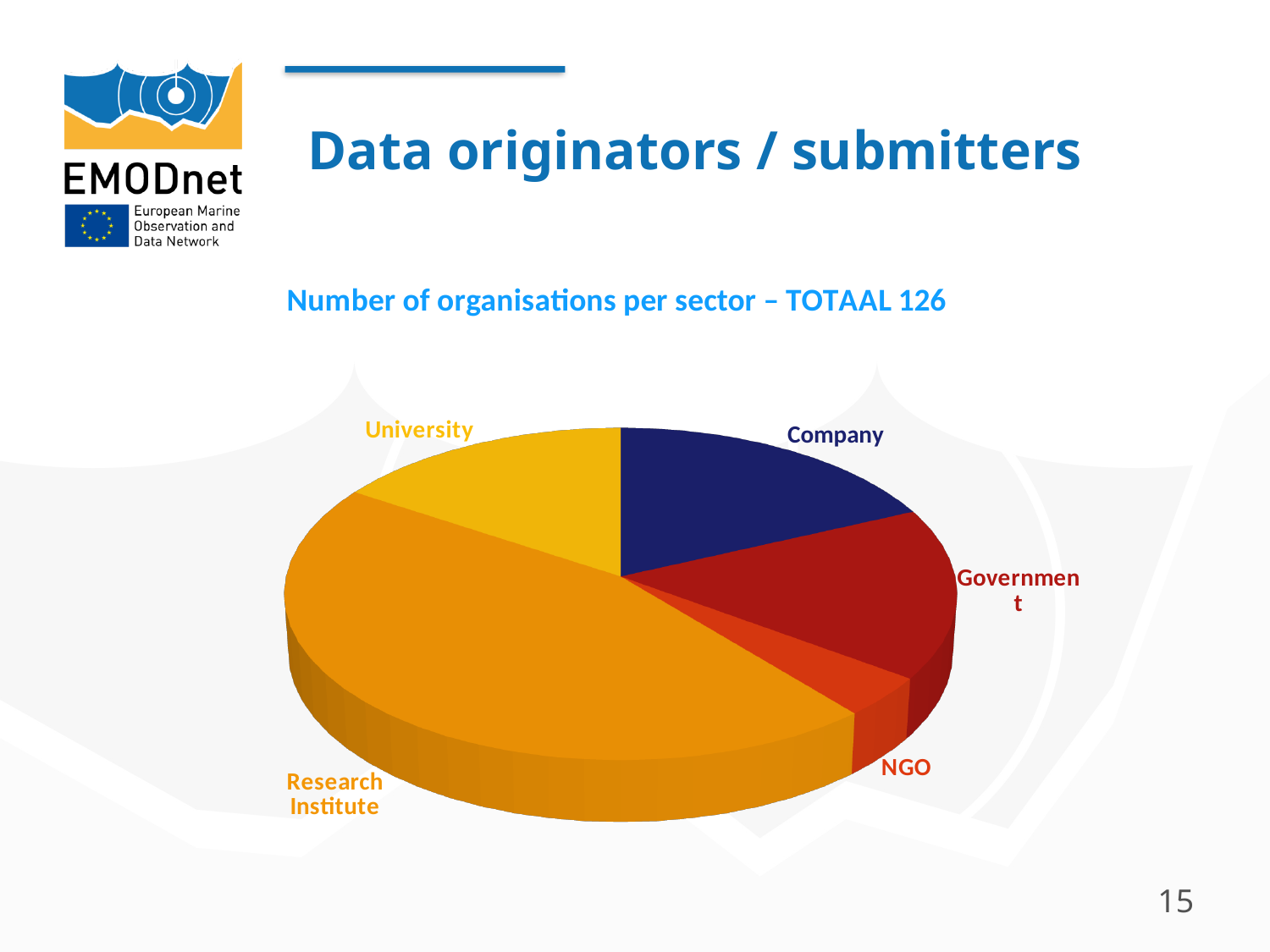
Which slice is larger, Research Institute or Company? Research Institute Which slice is larger, University or NGO? University What is the title of the pie chart? Number of organisations per sector – TOTAAL 126 Which slice is larger, Government or NGO? Government Which sector has the smallest slice of the pie chart? NGO What kind of chart is shown on the slide? pie chart How many sectors (slices) does the pie chart show? 5 Which sector has the largest slice of the pie chart? Research Institute What total number of organisations is stated in the chart title? 126